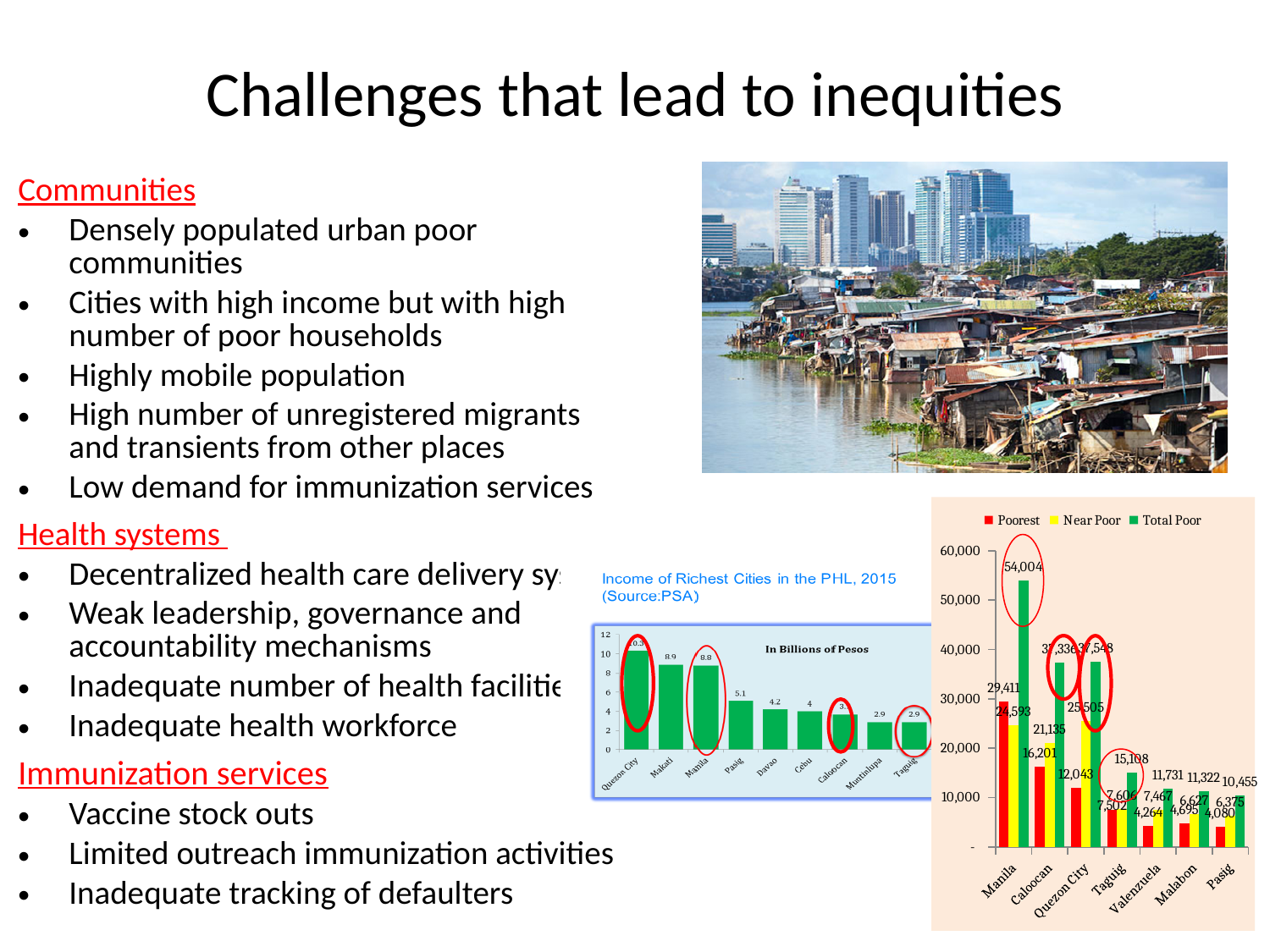
In the 'Income of Richest Cities in the PHL, 2015' chart, what is the value for Pasig? 5.1 How many series does the legend list in the chart at the bottom right (Poorest / Near Poor / Total Poor)? 3 In the 'Income of Richest Cities in the PHL, 2015' chart, what is the value for Makati? 8.9 In the bottom-right chart, what is the Near Poor value for Quezon City? 25,505 In the bottom-right chart, what is the Poorest value for Manila? 29,411 In the 'Income of Richest Cities in the PHL, 2015' chart, which city has the highest income? Quezon City In the bottom-right chart, what is the Total Poor value for Manila? 54,004 What kind of chart is the 'Income of Richest Cities in the PHL, 2015' chart? bar chart How many cities are shown in the 'Income of Richest Cities in the PHL, 2015' chart? 9 In the bottom-right chart, which city has the highest Total Poor value? Manila In the bottom-right chart, which is larger: the Poorest value for Caloocan or the Poorest value for Quezon City? Caloocan In the 'Income of Richest Cities in the PHL, 2015' chart, do the values rise or fall from left to right? fall